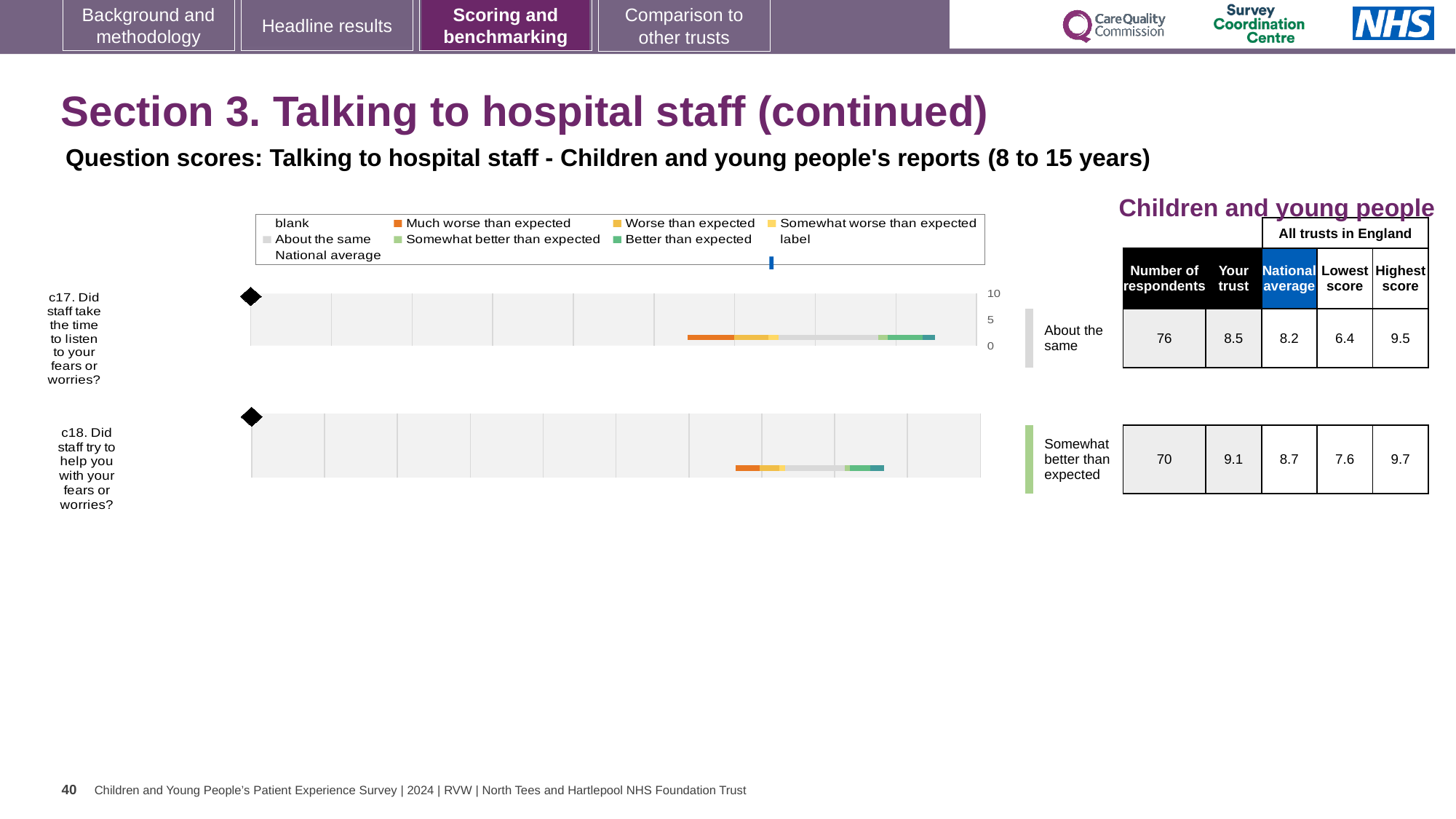
What kind of chart is used to show the question scores for c17 and c18? bar chart How many questions (categories) are plotted on the chart? 2 How many respondents answered question c17? 76 What is the national average score for c17? 8.2 What is the difference between the trust's score for c18 and its score for c17? 0.6 What is the trust's score for c18 (Did staff try to help you with your fears or worries?)? 9.1 What is the highest score among all trusts in England for c18? 9.7 Is the trust's score for c17 greater or less than 5 on the chart's axis? greater What is the trust's score for c17 (Did staff take the time to listen to your fears or worries?)? 8.5 What benchmark category is the trust's result for c18 placed in? Somewhat better than expected What is the difference between the highest and lowest scores across all trusts in England for c17? 3.1 Which question has the higher trust score, c17 or c18? c18